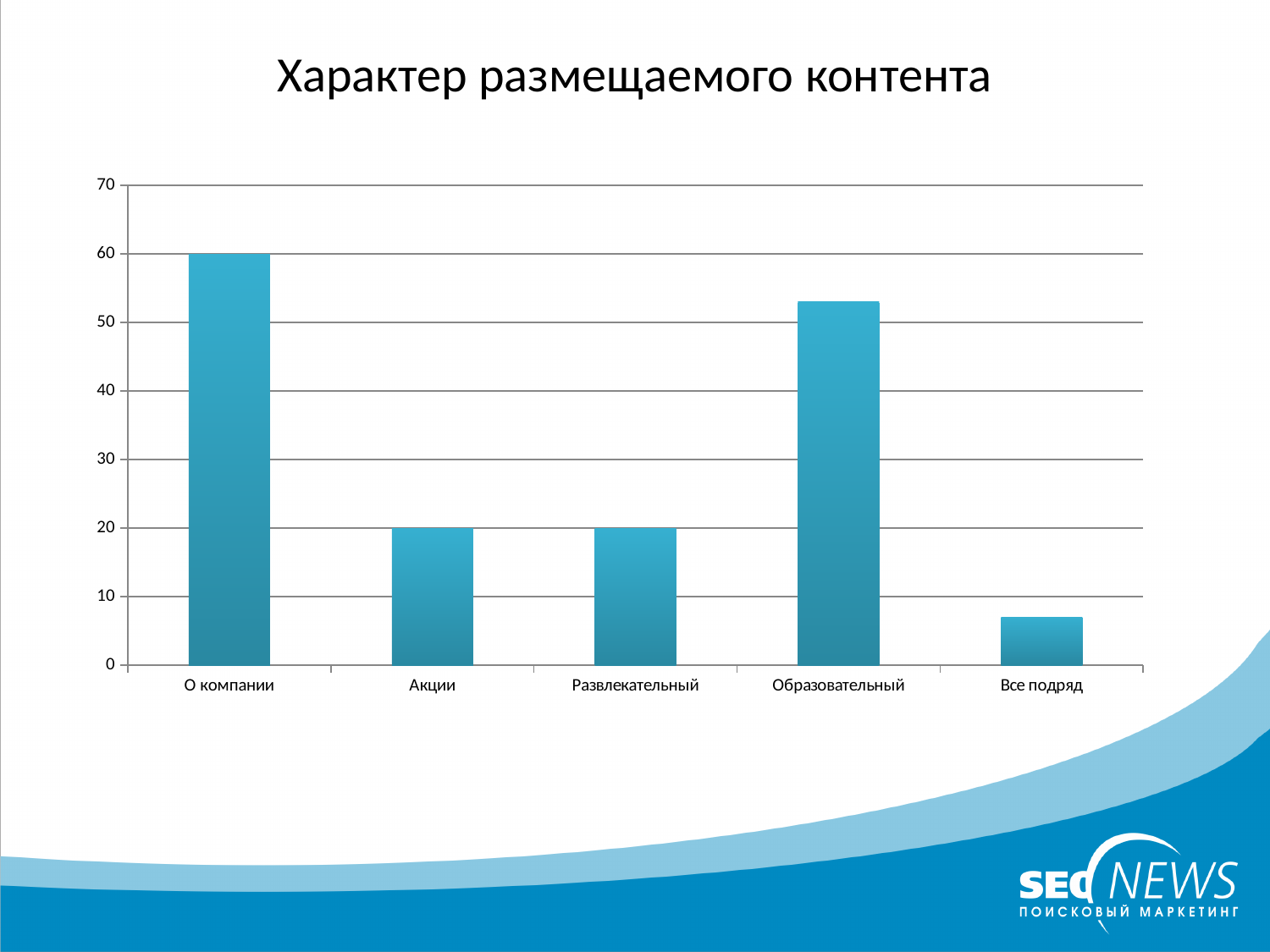
What is the value for Развлекательный? 20 Is the value for Образовательный greater or less than 50? greater What kind of chart is shown on the slide? bar chart What is the value for Акции? 20 How many categories are shown on the x axis? 5 What is the difference between the values for О компании and Акции? 40 Which category has the lowest value? Все подряд Which is larger, the value for О компании or the value for Образовательный? О компании Is the value for Все подряд greater or less than 10? less What is the value for О компании? 60 What is the title of the chart? Характер размещаемого контента Which category has the highest value? О компании